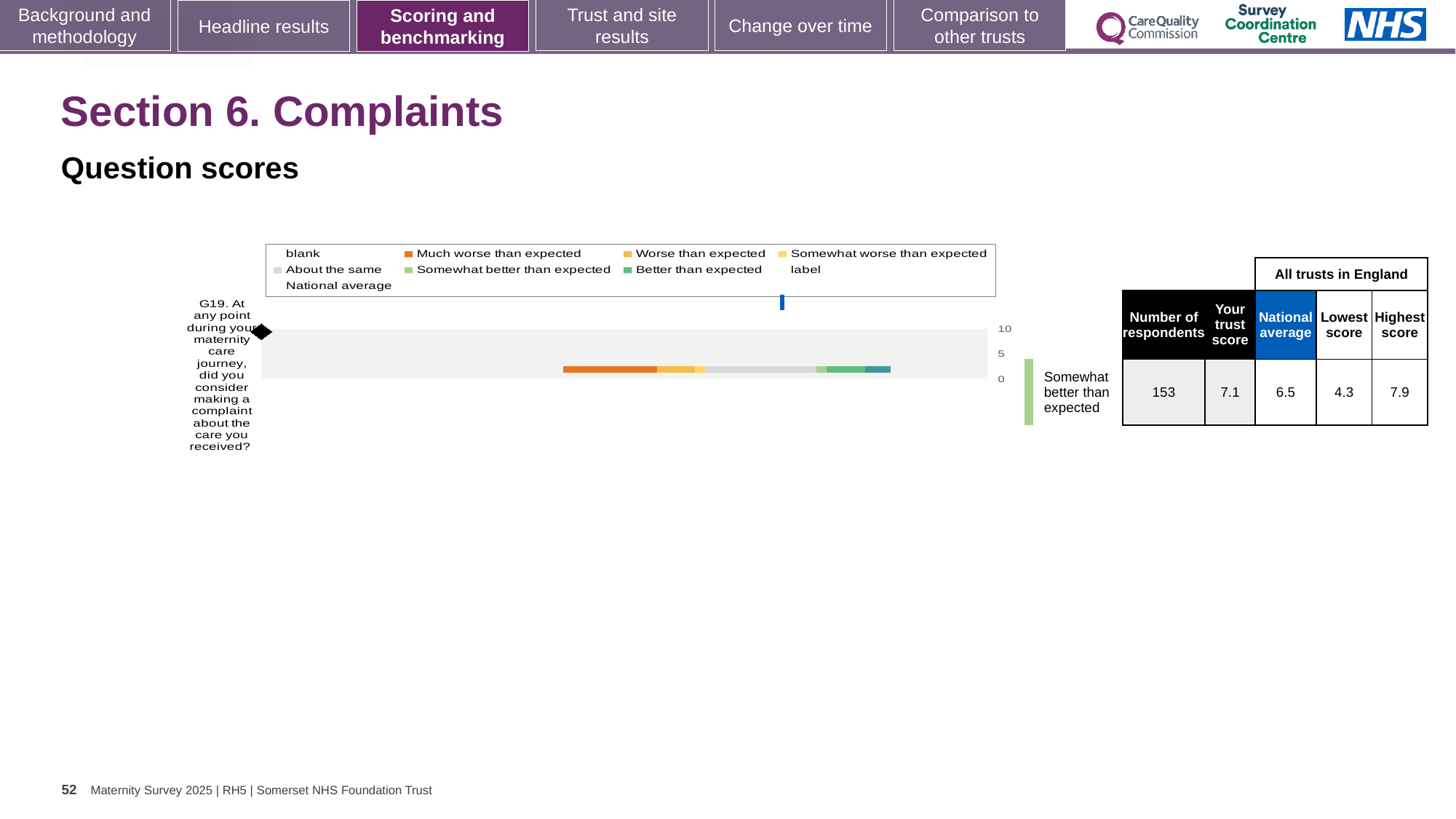
Is the trust score for question G19 greater or less than 5? greater Which benchmark category does the trust's score for G19 fall into? Somewhat better than expected What is the national average score for question G19? 6.5 How many respondents answered question G19? 153 Which question is plotted in the chart? G19. At any point during your maternity care journey, did you consider making a complaint about the care you received? What kind of chart is shown on the slide? bar chart What is the highest score among all trusts in England for question G19? 7.9 What is the lowest score among all trusts in England for question G19? 4.3 What is the difference between the highest and lowest scores for question G19? 3.6 Which is larger for question G19, the trust score or the national average? trust score How many survey questions are plotted in the chart? 1 What is the trust score for question G19? 7.1